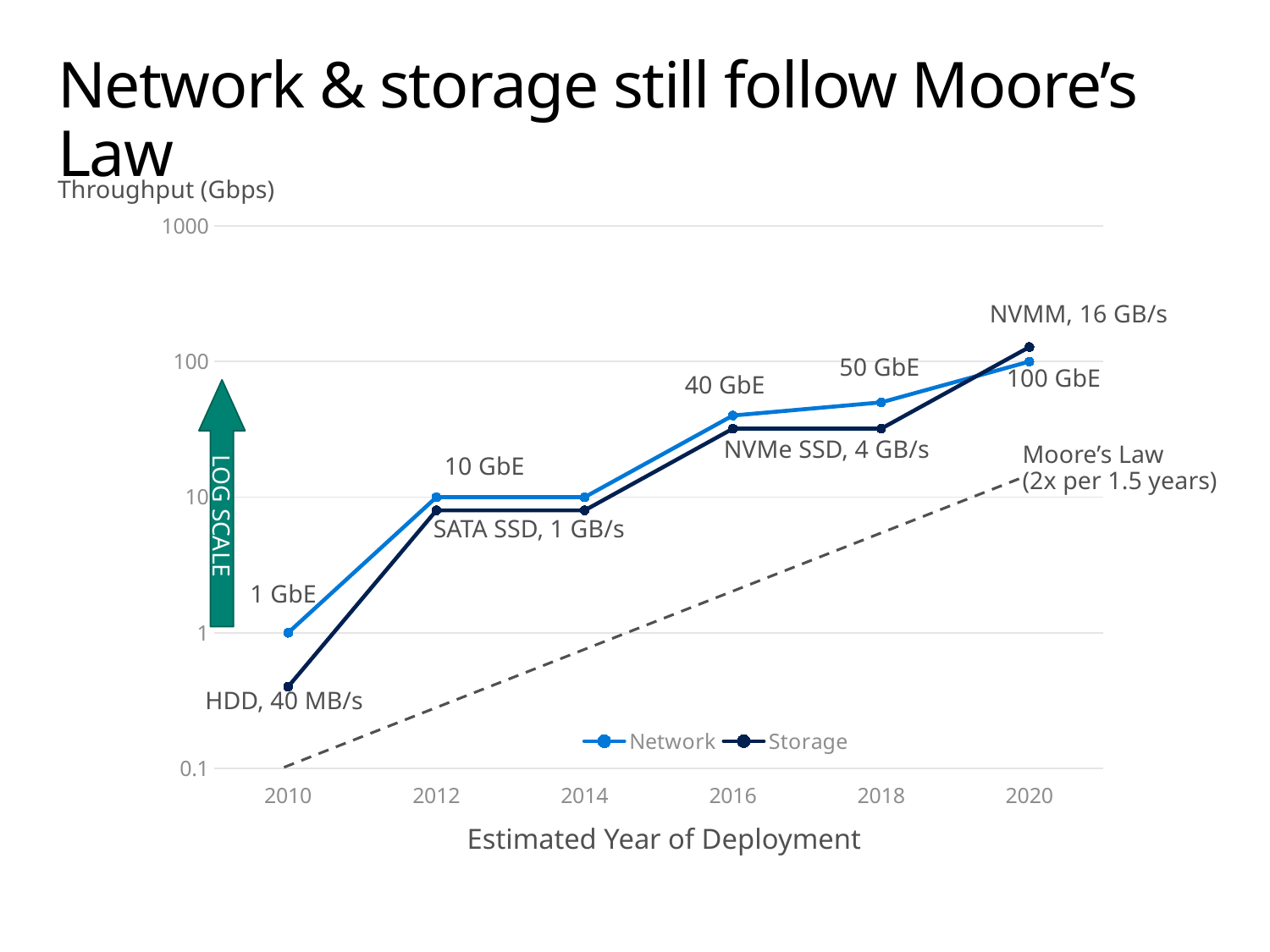
Does the Network series rise or fall from 2010 to 2020? rise What is the Storage data label at 2010? HDD, 40 MB/s How many years are marked on the x axis? 6 At 2020, which series has the higher value, Network or Storage? Storage What is the title of the x axis? Estimated Year of Deployment How many series does the legend list? 2 Is the Network value at 2018 greater or less than 10? greater What is the Storage data label at 2020? NVMM, 16 GB/s What kind of chart is shown on the slide? line chart Is the Storage value at 2010 greater or less than 1? less What is the Network data label at 2020? 100 GbE What is the Network data label at 2016? 40 GbE